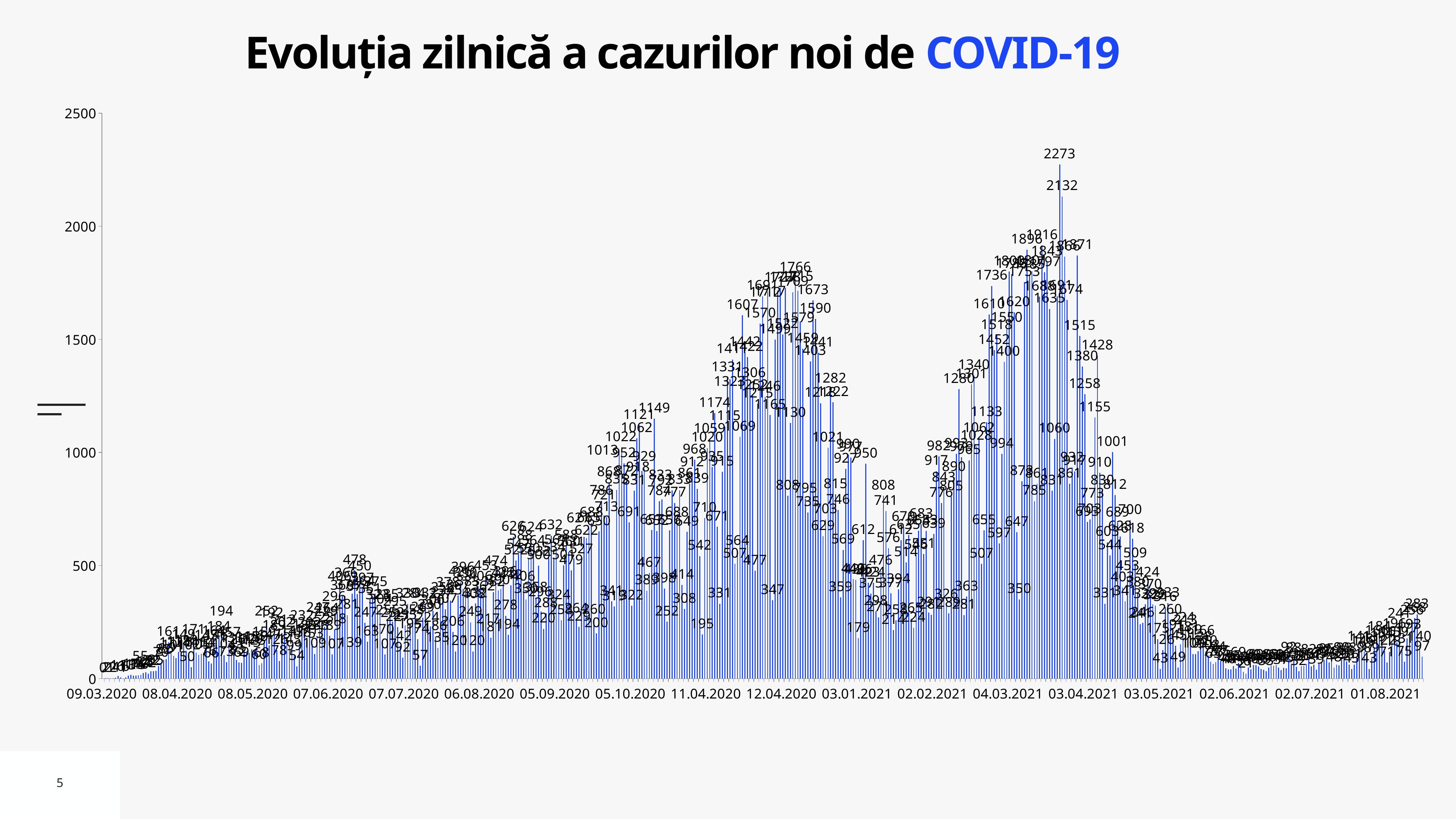
Is the value for the bar at 01.08.2021 greater or less than 500? less Do the values rise or fall along the x axis between 03.04.2021 and 02.06.2021? fall Which is larger, the peak labelled 2273 or the peak labelled 1766? 2273 What kind of chart is shown on the slide? bar chart What is the highest daily value labelled on the chart? 2273 What is the difference between the two highest labelled values, 2273 and 2132? 141 Is the value for the bar at 03.04.2021 greater or less than 1000? greater What is the highest tick value shown on the y axis? 2500 Is the value for the bar at 09.03.2020 greater or less than 500? less What is the second-highest value labelled on the chart, next to the 2273 peak? 2132 What is the title of the chart? Evoluția zilnică a cazurilor noi de COVID-19